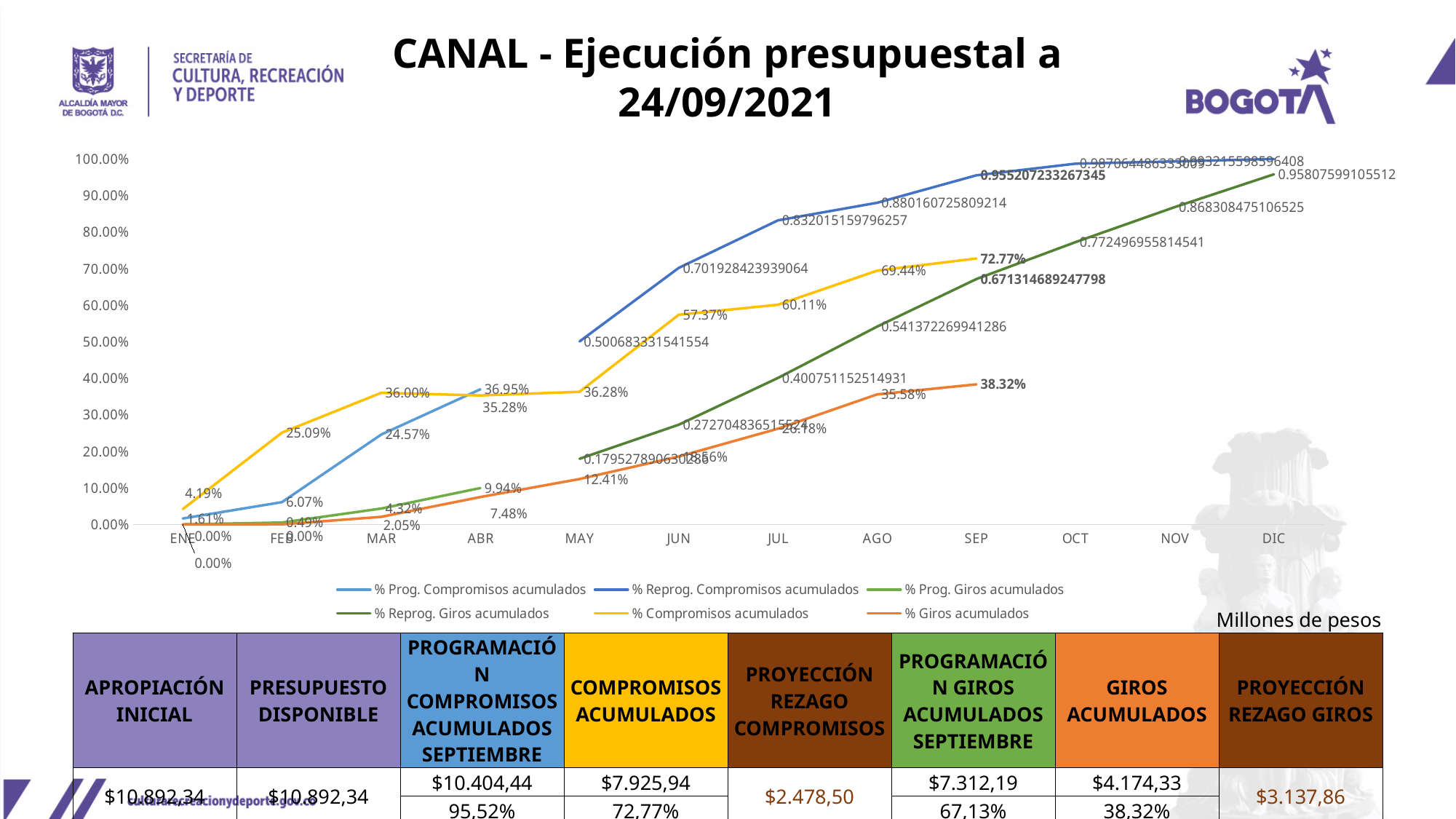
What is the value of % Compromisos acumulados in FEB? 25.09% Do the values of % Compromisos acumulados generally rise or fall from ENE to SEP? Rise What is the value of % Giros acumulados in SEP? 38.32% How many series does the legend list? 6 What kind of chart is shown on the slide? Line chart What is the difference between % Compromisos acumulados and % Giros acumulados in SEP? 34.45% What is the value of % Giros acumulados in AGO? 35.58% What is the value of % Compromisos acumulados in SEP? 72.77% What is the value of % Prog. Compromisos acumulados in MAR? 24.57% In SEP, which is larger: % Compromisos acumulados or % Giros acumulados? % Compromisos acumulados Is the value of % Reprog. Compromisos acumulados in JUL greater or less than 80%? greater How many months are shown on the x axis? 12